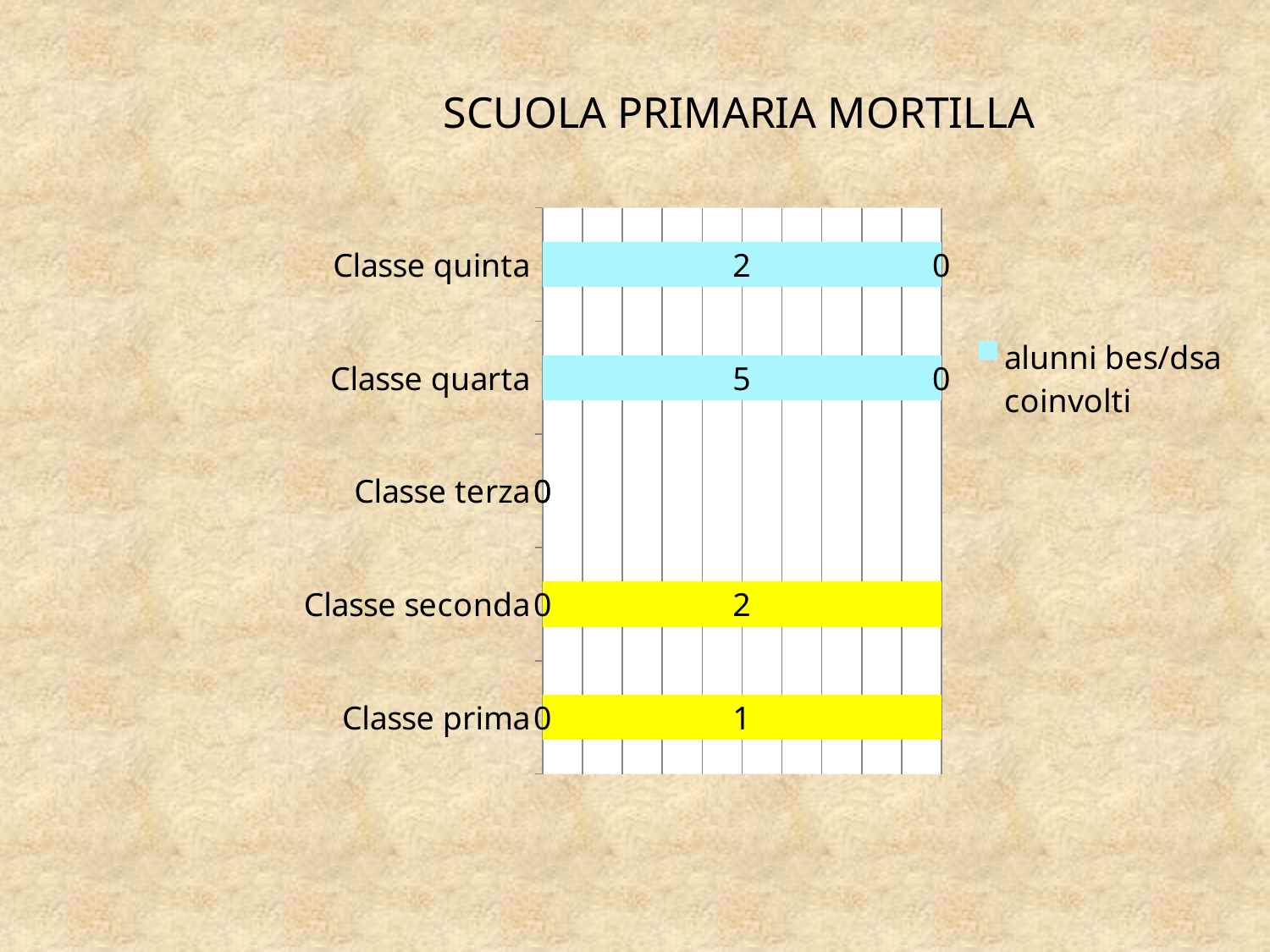
Is the number printed in the bar for Classe quarta larger than the number printed in the bar for Classe prima? Yes What number is printed in the middle of the bar for Classe seconda? 2 What kind of chart is shown on the slide? bar chart What is the title of the chart? SCUOLA PRIMARIA MORTILLA How many series does the legend list? 1 How many classes (categories) are listed on the chart's vertical axis? 5 What number is printed in the middle of the bar for Classe quinta? 2 What number is printed in the middle of the bar for Classe prima? 1 What number is printed in the middle of the bar for Classe quarta? 5 What is the legend entry shown on the chart? alunni bes/dsa coinvolti Which class has the largest number printed in its bar? Classe quarta What value is printed next to Classe terza? 0